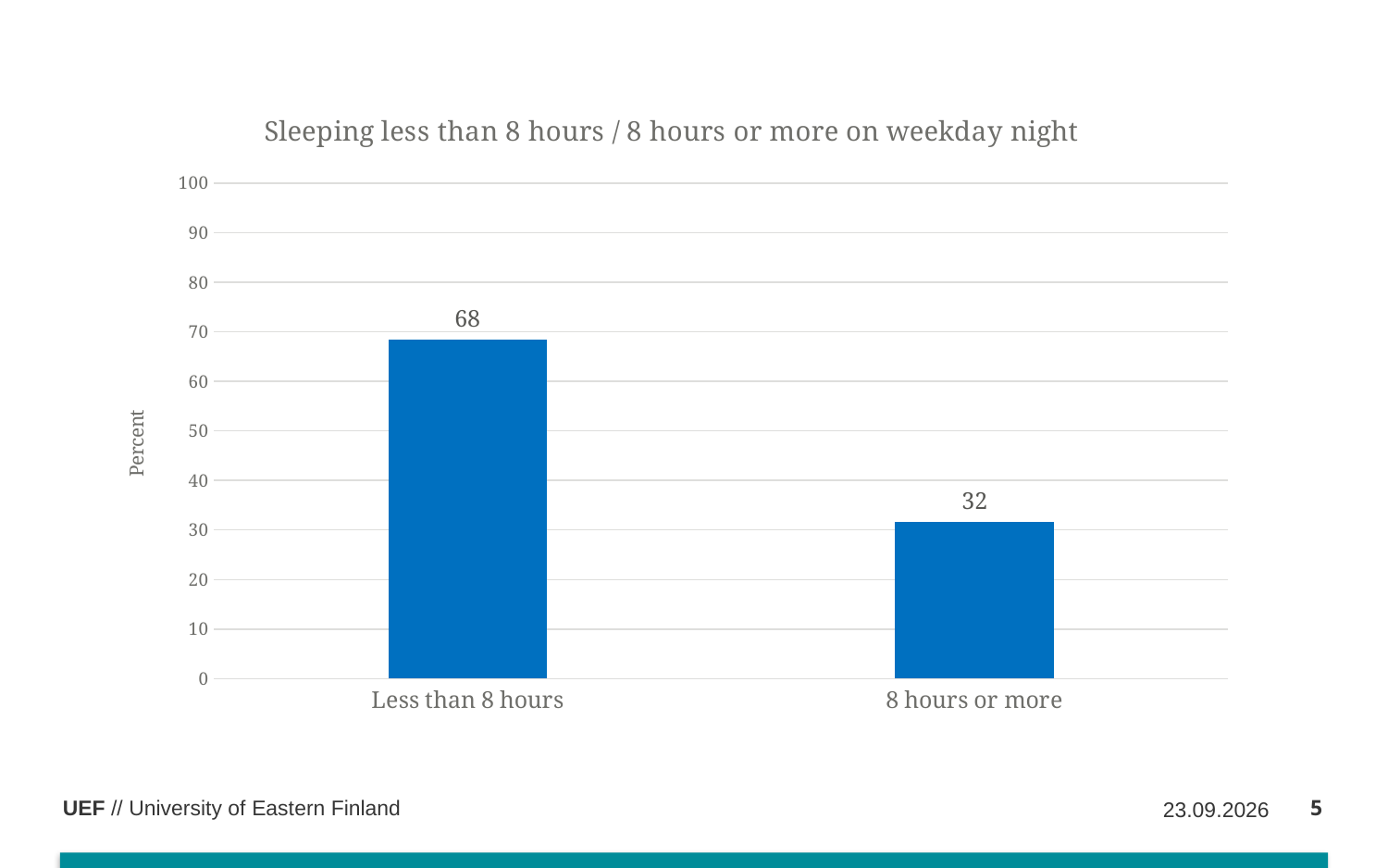
Which category has the lowest value? 8 hours or more What is the value for "8 hours or more"? 32 How many categories are shown on the x axis? 2 Is the value for "Less than 8 hours" greater or less than 60? greater What is the difference between the values for "Less than 8 hours" and "8 hours or more"? 36 What is the label of the y axis? Percent Which category has the highest value? Less than 8 hours What kind of chart is shown on the slide? Bar chart What is the value for "Less than 8 hours"? 68 What is the title of the chart? Sleeping less than 8 hours / 8 hours or more on weekday night Which is larger, the value for "Less than 8 hours" or for "8 hours or more"? Less than 8 hours Is the value for "8 hours or more" greater or less than 40? less